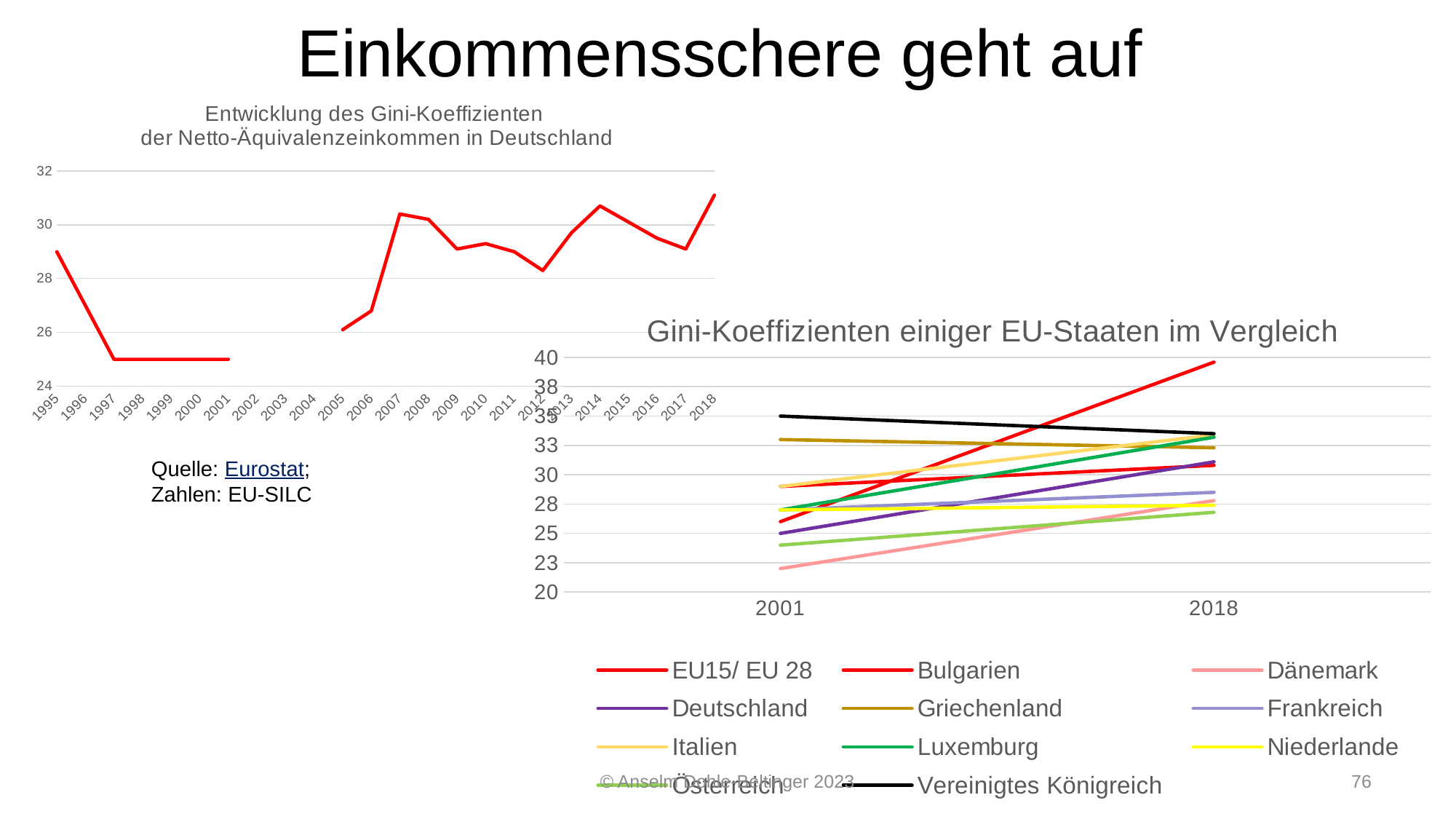
What kind of chart is the left chart titled 'Entwicklung des Gini-Koeffizienten der Netto-Äquivalenzeinkommen in Deutschland'? line chart In the right chart 'Gini-Koeffizienten einiger EU-Staaten im Vergleich', is the value for Bulgarien in 2018 greater or less than 38? greater In the right chart 'Gini-Koeffizienten einiger EU-Staaten im Vergleich', which is larger in 2001: Bulgarien or Vereinigtes Königreich? Vereinigtes Königreich In the left chart for Deutschland, is the value for 2018 greater or less than 30? greater In the left chart for Deutschland, does the line rise or fall from 1995 to 1997? fall In the right chart 'Gini-Koeffizienten einiger EU-Staaten im Vergleich', does the line for Vereinigtes Königreich rise or fall from 2001 to 2018? fall In the right chart 'Gini-Koeffizienten einiger EU-Staaten im Vergleich', which series has the highest value in 2001? Vereinigtes Königreich How many points are on the x axis of the right chart 'Gini-Koeffizienten einiger EU-Staaten im Vergleich'? 2 How many series does the legend of the right chart 'Gini-Koeffizienten einiger EU-Staaten im Vergleich' list? 11 In the right chart 'Gini-Koeffizienten einiger EU-Staaten im Vergleich', which country has the lowest value in 2001? Dänemark According to the text on the slide, what is the source (Quelle) of the data? Eurostat In the right chart 'Gini-Koeffizienten einiger EU-Staaten im Vergleich', which country has the highest value in 2018? Bulgarien